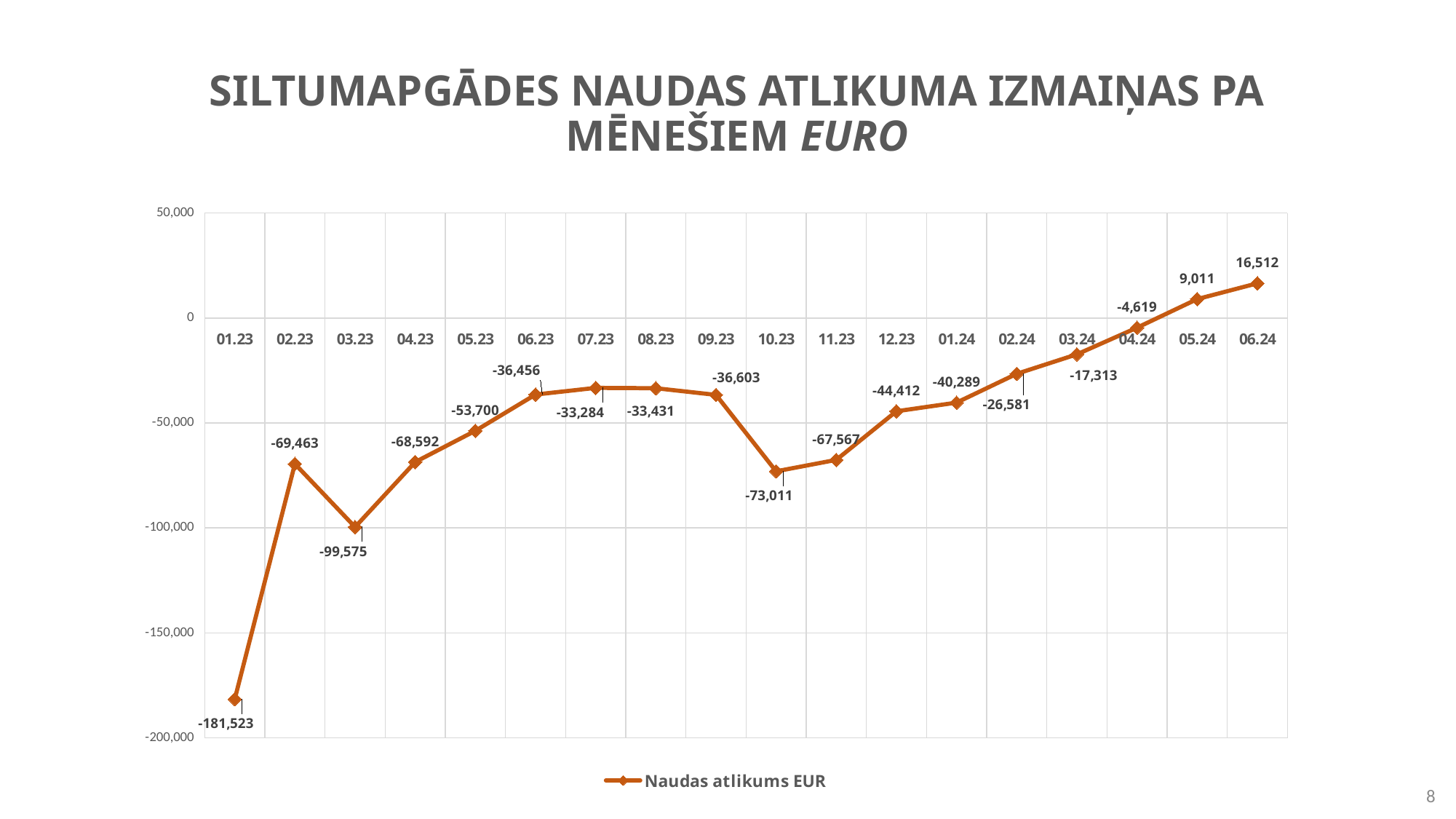
What kind of chart is shown on the slide? line chart What is the value for 01.23? -181,523 Which month has the lowest value? 01.23 How many series does the legend list? 1 What is the value for 10.23? -73,011 Which month has the highest value? 06.24 What is the value for 06.24? 16,512 What is the difference between the values for 02.23 and 03.23? 30,112 Do the values rise or fall from 10.23 to 06.24? rise Which is larger, the value for 07.23 or the value for 08.23? 07.23 What is the difference between the values for 06.24 and 05.24? 7,501 How many months are plotted on the chart? 18